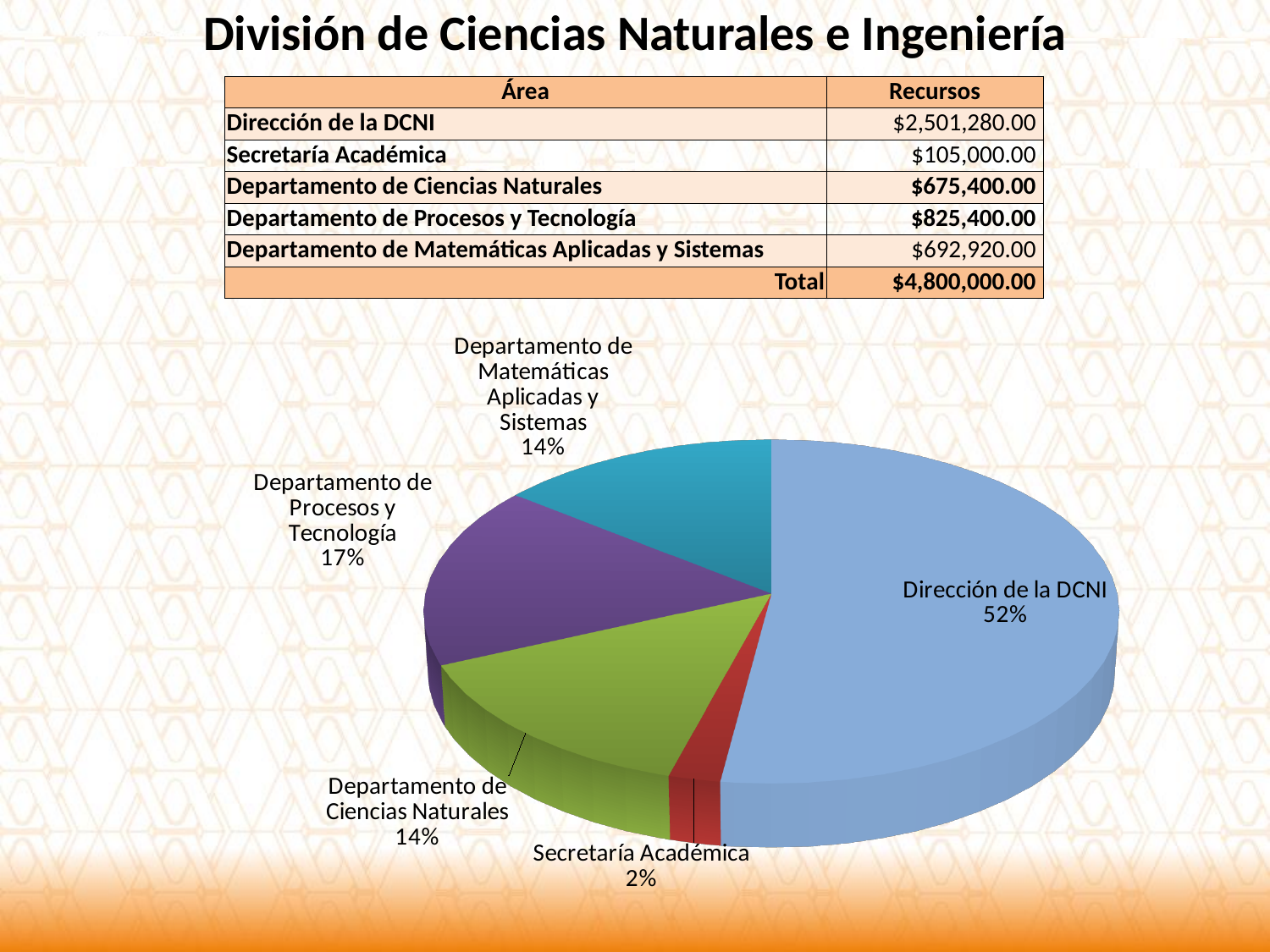
What share of the pie does Departamento de Ciencias Naturales represent? 14% What kind of chart is shown on the slide? pie chart What share of the pie does Departamento de Procesos y Tecnología represent? 17% How many slices does the pie chart have? 5 Which slice of the pie chart is the smallest? Secretaría Académica Which slice is larger: Departamento de Procesos y Tecnología or Departamento de Ciencias Naturales? Departamento de Procesos y Tecnología What share of the pie does Secretaría Académica represent? 2% What colour is the Dirección de la DCNI slice in the pie chart? light blue Which slice of the pie chart is the largest? Dirección de la DCNI What is the difference in percentage points between the Dirección de la DCNI slice and the Departamento de Procesos y Tecnología slice? 35